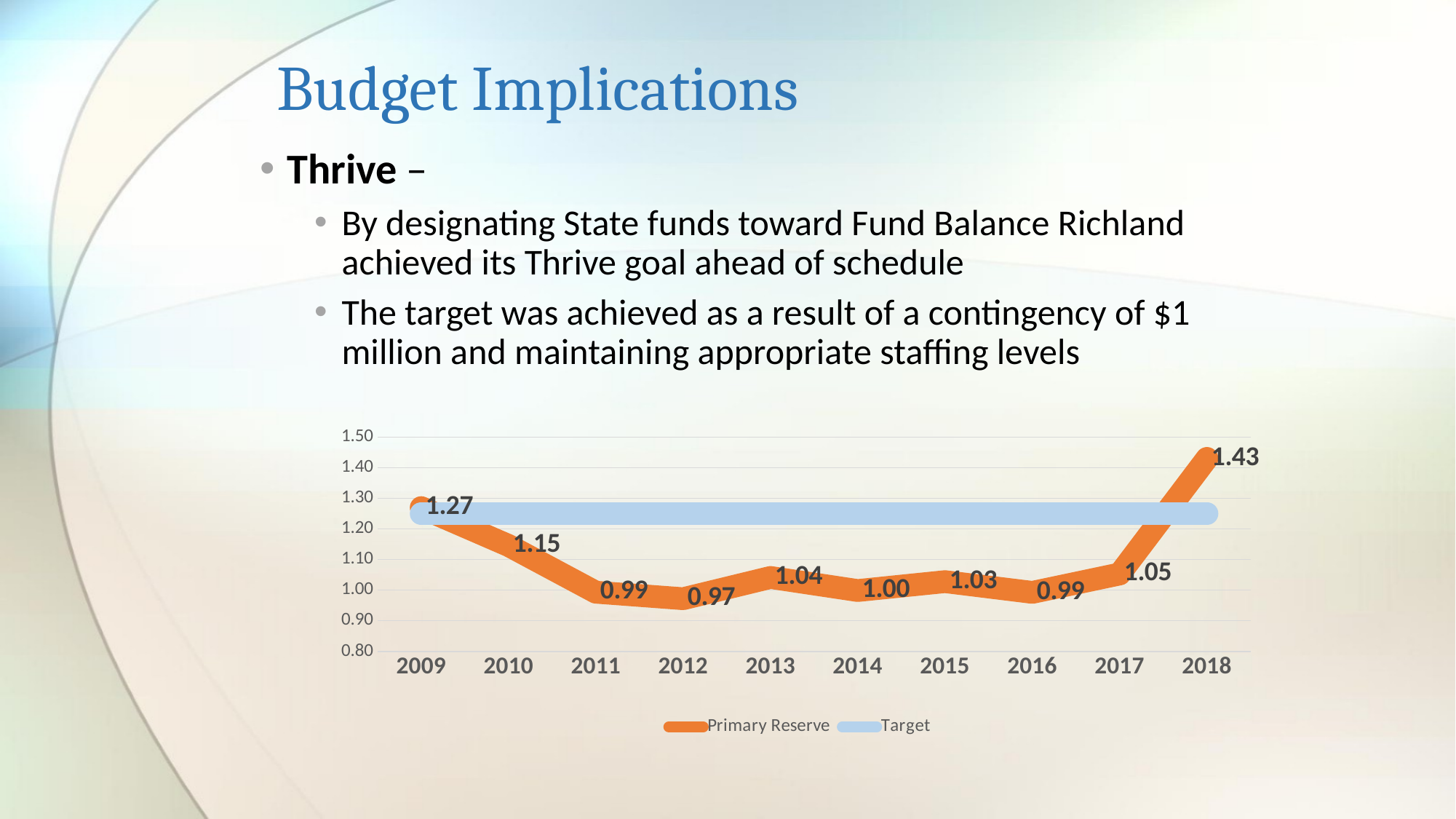
Does the Primary Reserve rise or fall from 2009 to 2012? fall What is the Primary Reserve value for 2012? 0.97 What kind of chart is shown on the slide? line chart How many years are shown on the x axis? 10 How many series does the legend list? 2 Which year has a higher Primary Reserve, 2010 or 2013? 2010 In which year is the Primary Reserve highest? 2018 Is the Target line value greater or less than 1.20? greater What is the difference between the Primary Reserve in 2018 and in 2017? 0.38 What is the Primary Reserve value for 2009? 1.27 In which year is the Primary Reserve lowest? 2012 What is the Primary Reserve value for 2018? 1.43